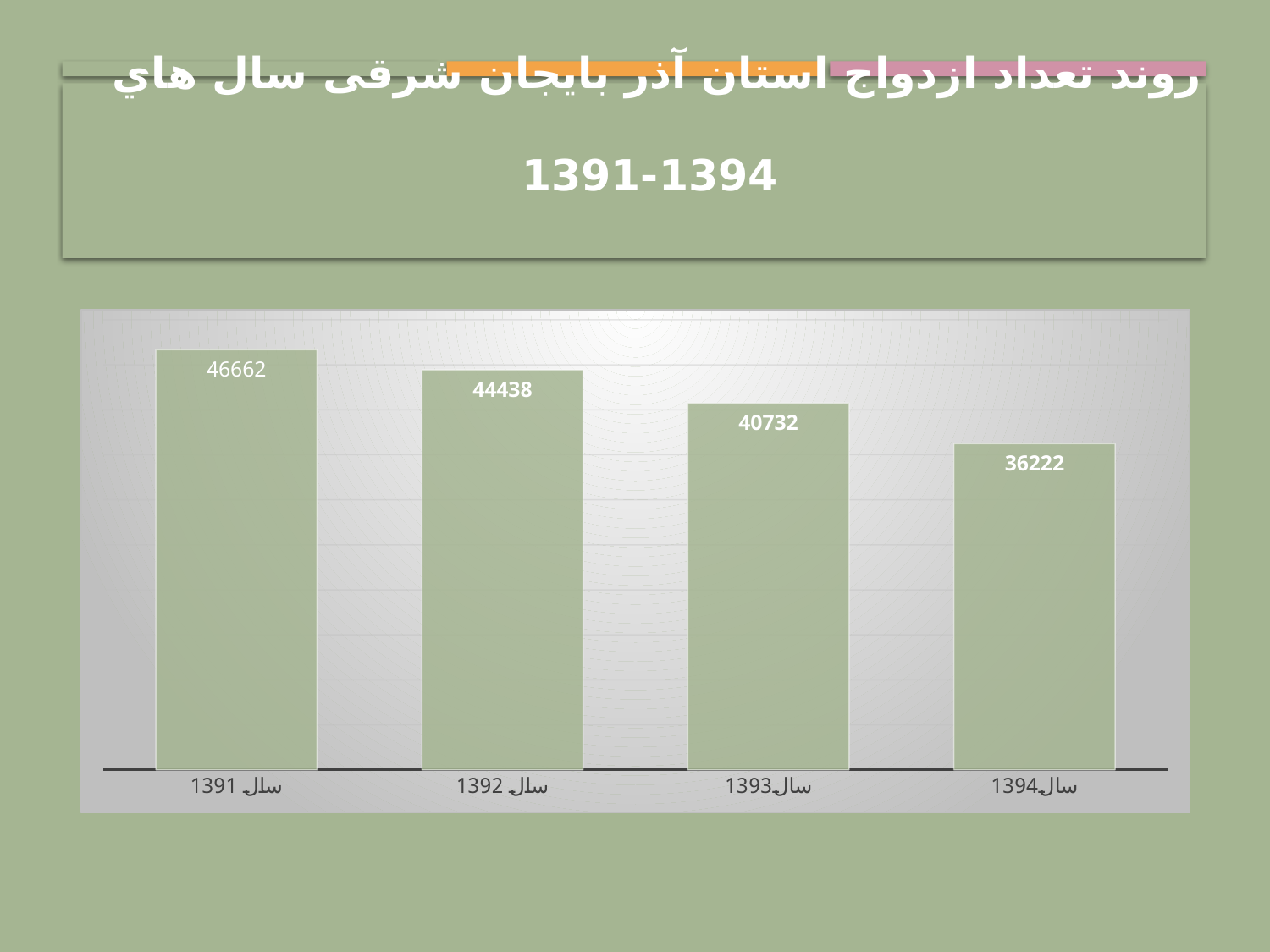
What is the value shown for سال 1393? 40732 What is the difference between the values for سال 1391 and سال 1394? 10440 Which year has the lowest value? سال 1394 Which year has the highest value? سال 1391 What kind of chart is shown on the slide? Bar chart What is the difference between the values for سال 1392 and سال 1393? 3706 Do the values rise or fall from سال 1391 to سال 1394? Fall What is the value shown for سال 1391? 46662 What is the value shown for سال 1394? 36222 How many bars are shown in the chart? 4 Which is larger, the value for سال 1392 or the value for سال 1393? سال 1392 What is the value shown for سال 1392? 44438